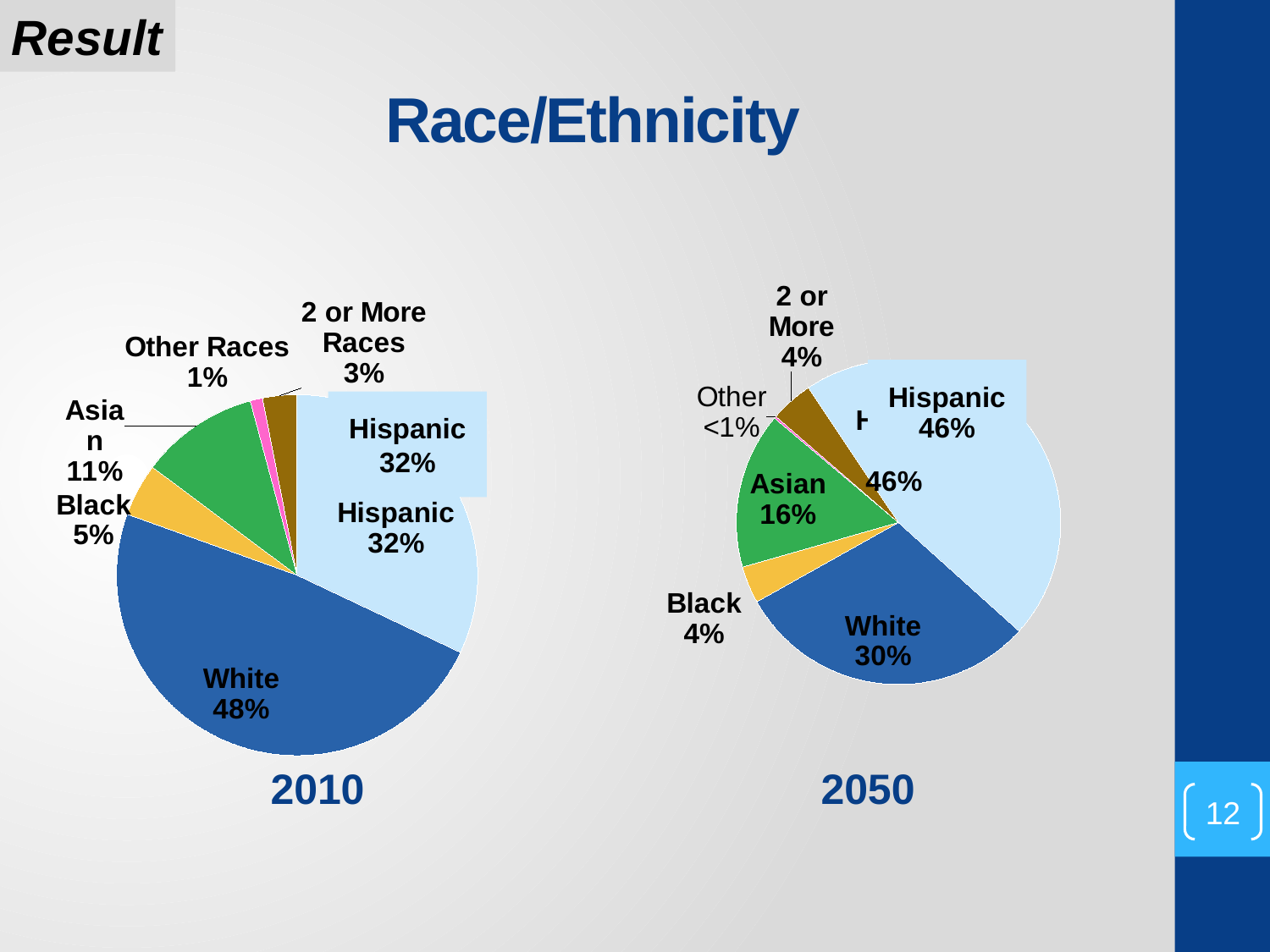
In the 2050 pie chart, which is larger, the Asian share or the Black share? Asian In the 2050 pie chart, which group has the largest share? Hispanic In the 2050 pie chart, what share is Asian? 16% In the 2010 pie chart, which group has the largest share? White What is the difference between the White share in 2010 and the White share in 2050? 18% In the 2010 pie chart, what is the difference between the Asian share and the Black share? 6% In the 2010 pie chart, what share is Hispanic? 32% In the 2010 pie chart, which group has the smallest share? Other Races In the 2050 pie chart, what share is Hispanic? 46% What type of chart is used for the 2010 and 2050 data? Pie chart What is the title of the slide's charts? Race/Ethnicity In the 2010 pie chart, what share is White? 48%